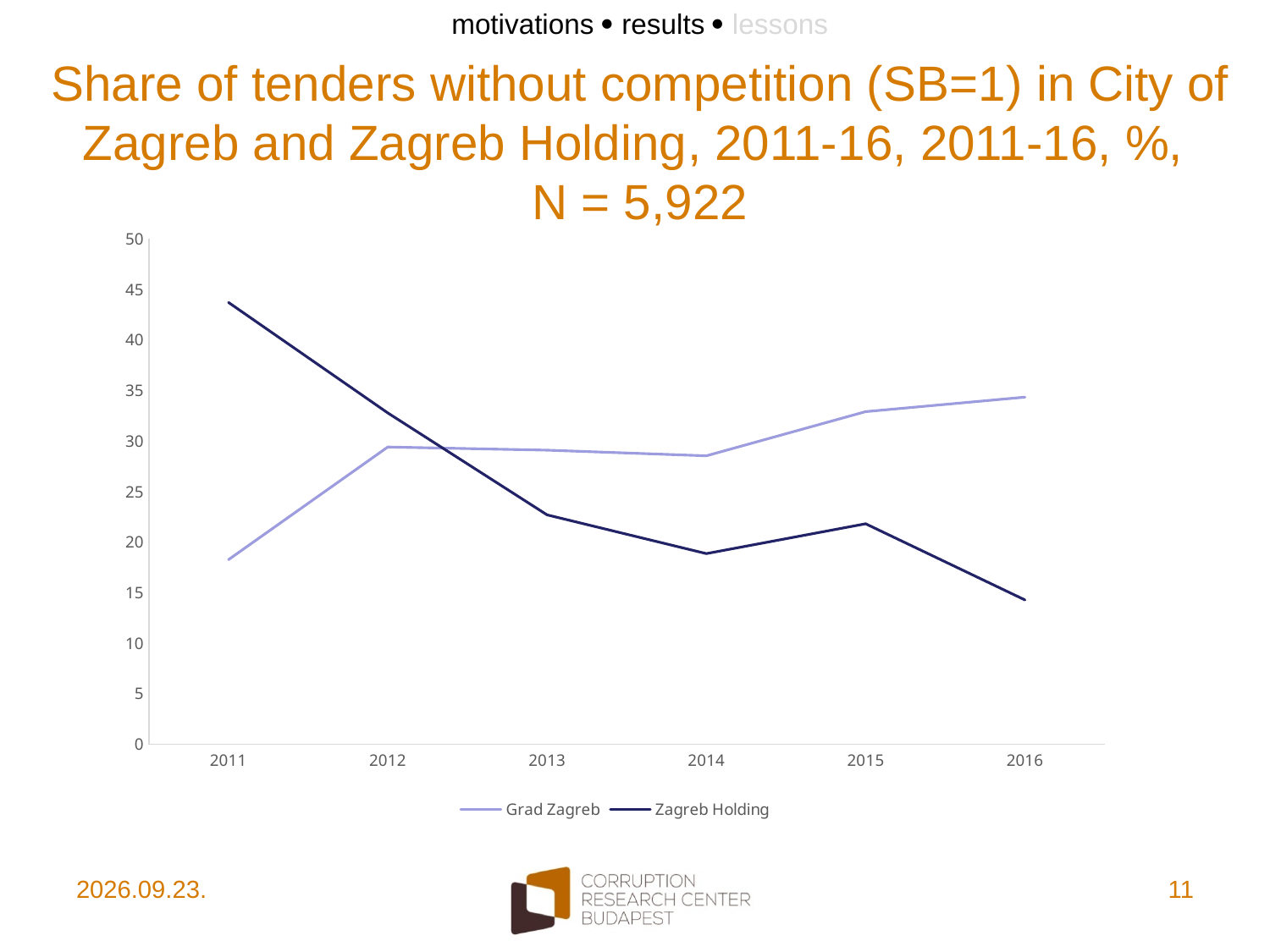
In which year is the Grad Zagreb value lowest? 2011 Is the value for Zagreb Holding in 2011 greater or less than 40? greater How many series does the legend list? 2 Is the value for Grad Zagreb in 2011 greater or less than 20? less Does the Zagreb Holding line generally rise or fall from 2011 to 2016? fall In which year is the Zagreb Holding value lowest? 2016 In which year is the Grad Zagreb value highest? 2016 In which year is the Zagreb Holding value highest? 2011 How many years are plotted along the x axis? 6 Which series has the larger value in 2011, Grad Zagreb or Zagreb Holding? Zagreb Holding Which series has the larger value in 2016, Grad Zagreb or Zagreb Holding? Grad Zagreb What kind of chart is shown on the slide? line chart